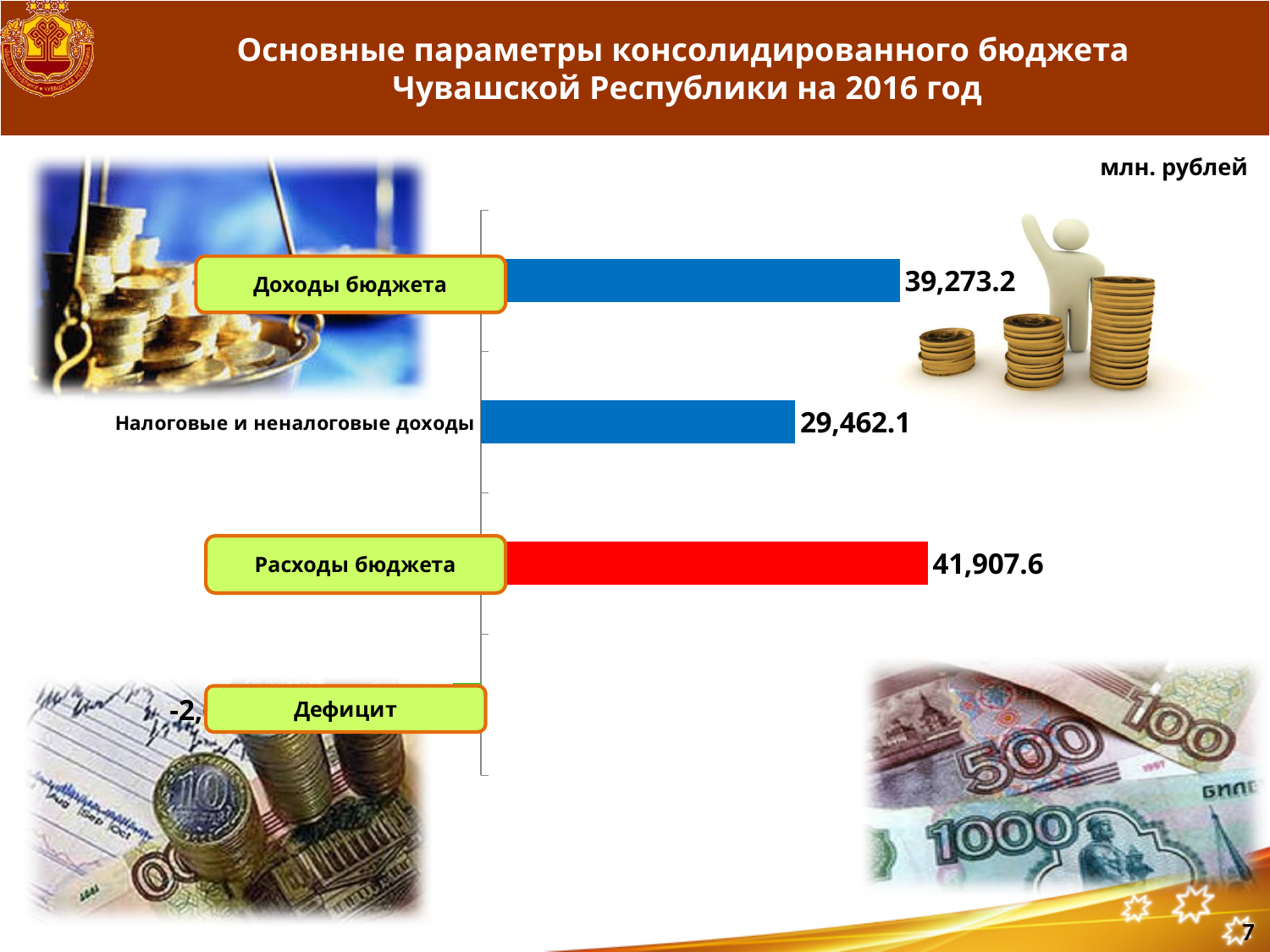
What is the difference between Доходы бюджета and Налоговые и неналоговые доходы? 9,811.1 What is the value shown for Расходы бюджета? 41,907.6 What is the value shown for Доходы бюджета? 39,273.2 What is the difference between Расходы бюджета and Доходы бюджета? 2,634.4 What kind of chart is shown on the slide? Bar chart Which is larger, Налоговые и неналоговые доходы or Доходы бюджета? Доходы бюджета How many categories are shown on the chart? 4 Which category has the highest value on the chart? Расходы бюджета Among Доходы бюджета, Налоговые и неналоговые доходы and Расходы бюджета, which has the lowest value? Налоговые и неналоговые доходы Which is larger, Доходы бюджета or Расходы бюджета? Расходы бюджета What is the value shown for Налоговые и неналоговые доходы? 29,462.1 What colour is the bar for Расходы бюджета? Red